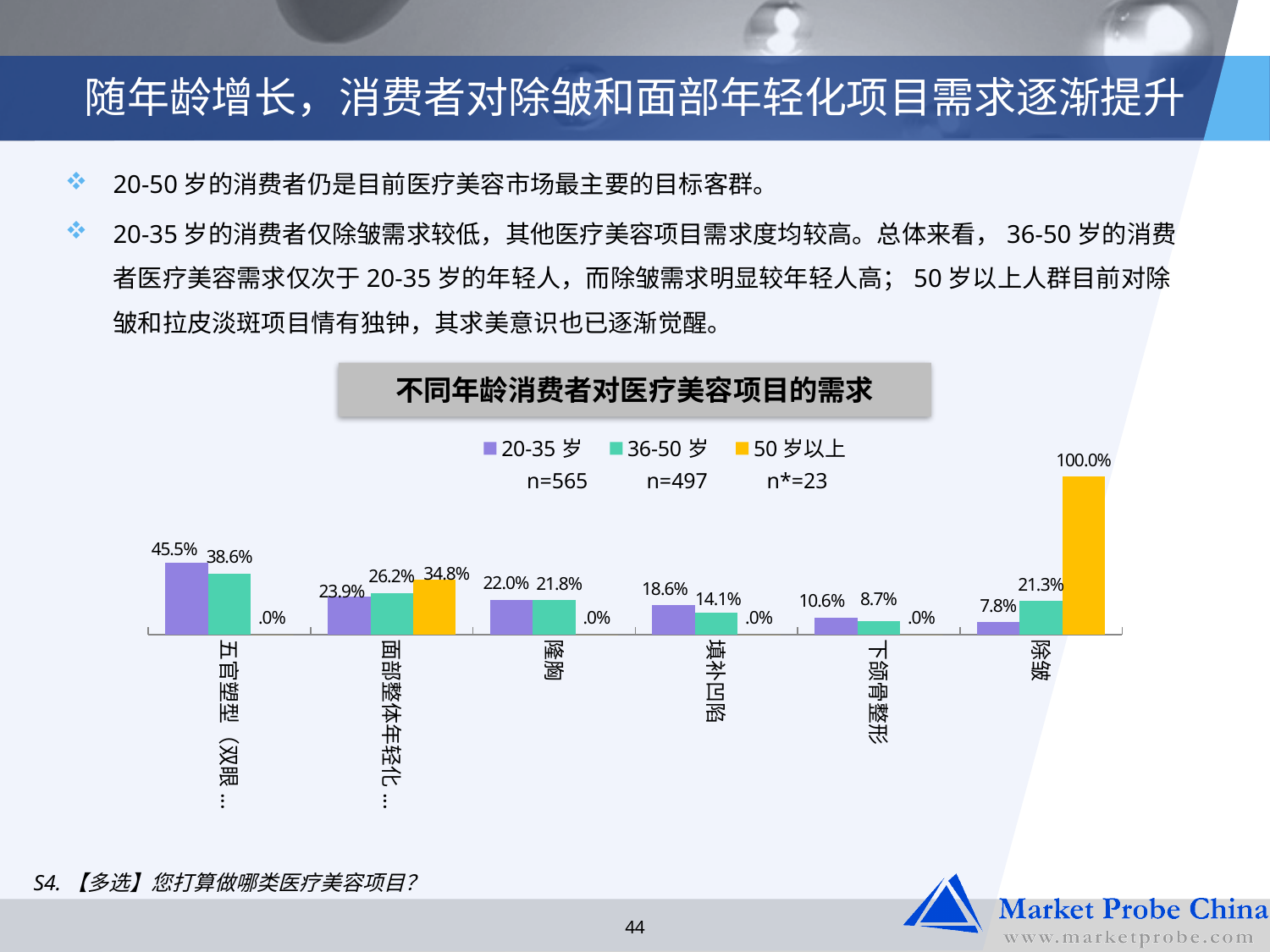
What sample size (n) is shown for the 36-50 岁 series? n=497 What is the difference between the 36-50 岁 and 20-35 岁 values in the 除皱 category? 13.5% How many series does the legend list? 3 Which category has the highest value for the 20-35 岁 series? 五官塑型 What is the value for 36-50 岁 in the 填补凹陷 category? 14.1% What is the value for 50 岁以上 in the 面部整体年轻化 category? 34.8% Which category has the lowest value for the 36-50 岁 series? 下颌骨整形 What is the value for 20-35 岁 in the 五官塑型 category? 45.5% In the 隆胸 category, which is larger: the 20-35 岁 value or the 36-50 岁 value? 20-35 岁 How many categories are shown on the x axis? 6 What is the value for 50 岁以上 in the 除皱 category? 100.0% What kind of chart is shown on the slide? bar chart